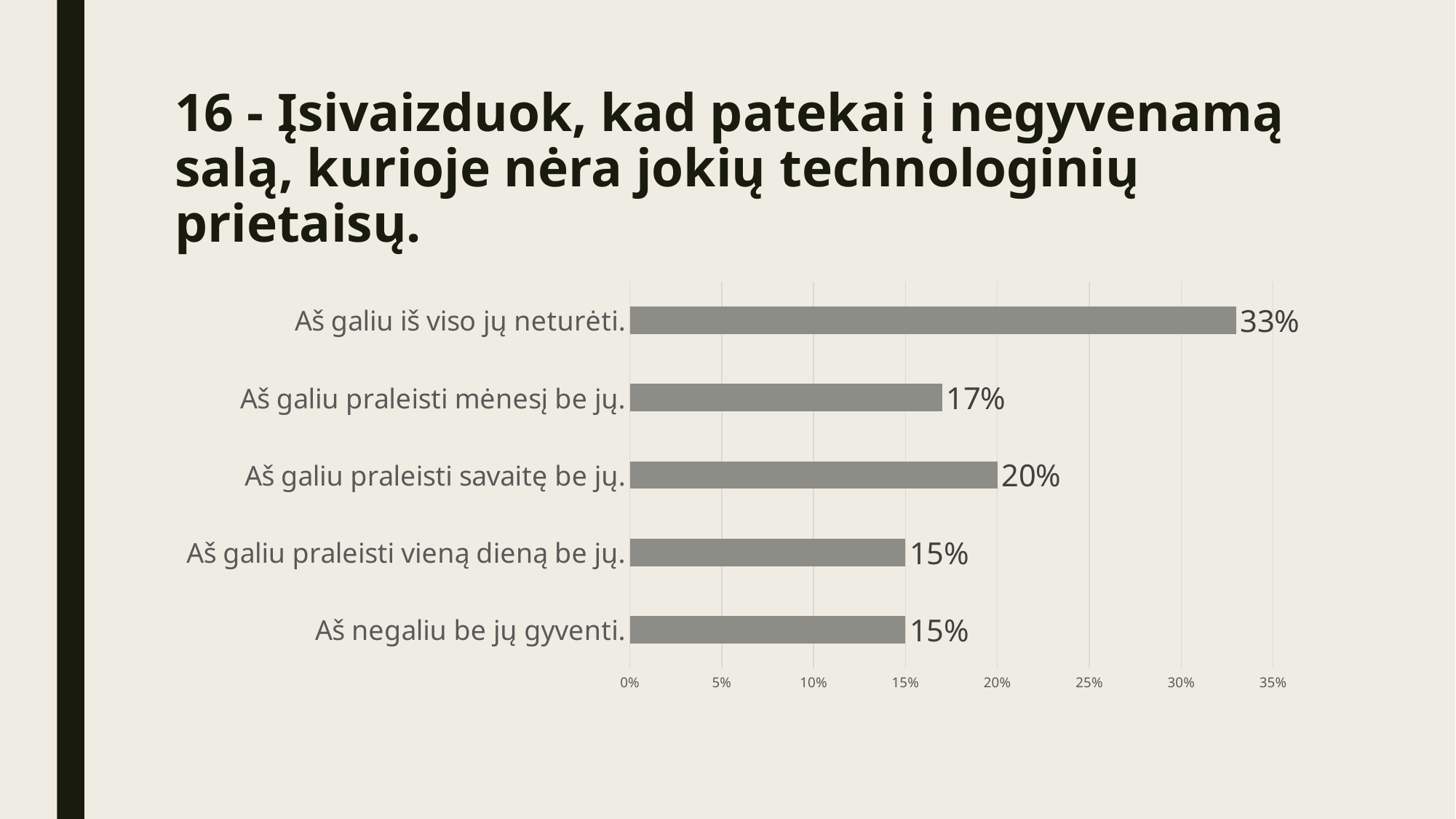
Is the value for "Aš galiu iš viso jų neturėti." greater or less than 30%? greater What is the value for "Aš negaliu be jų gyventi."? 15% What is the difference between the values for "Aš galiu praleisti savaitę be jų." and "Aš galiu praleisti mėnesį be jų."? 3% What is the difference between the values for "Aš galiu iš viso jų neturėti." and "Aš galiu praleisti savaitę be jų."? 13% Which is larger, the value for "Aš galiu praleisti savaitę be jų." or "Aš galiu praleisti mėnesį be jų."? Aš galiu praleisti savaitę be jų. How many categories are shown in the chart? 5 What is the value for "Aš galiu praleisti mėnesį be jų."? 17% What is the value for "Aš galiu praleisti savaitę be jų."? 20% Which category has the highest value? Aš galiu iš viso jų neturėti. What is the highest value shown on the x axis? 35% What is the value for "Aš galiu iš viso jų neturėti."? 33% What kind of chart is shown on the slide? bar chart